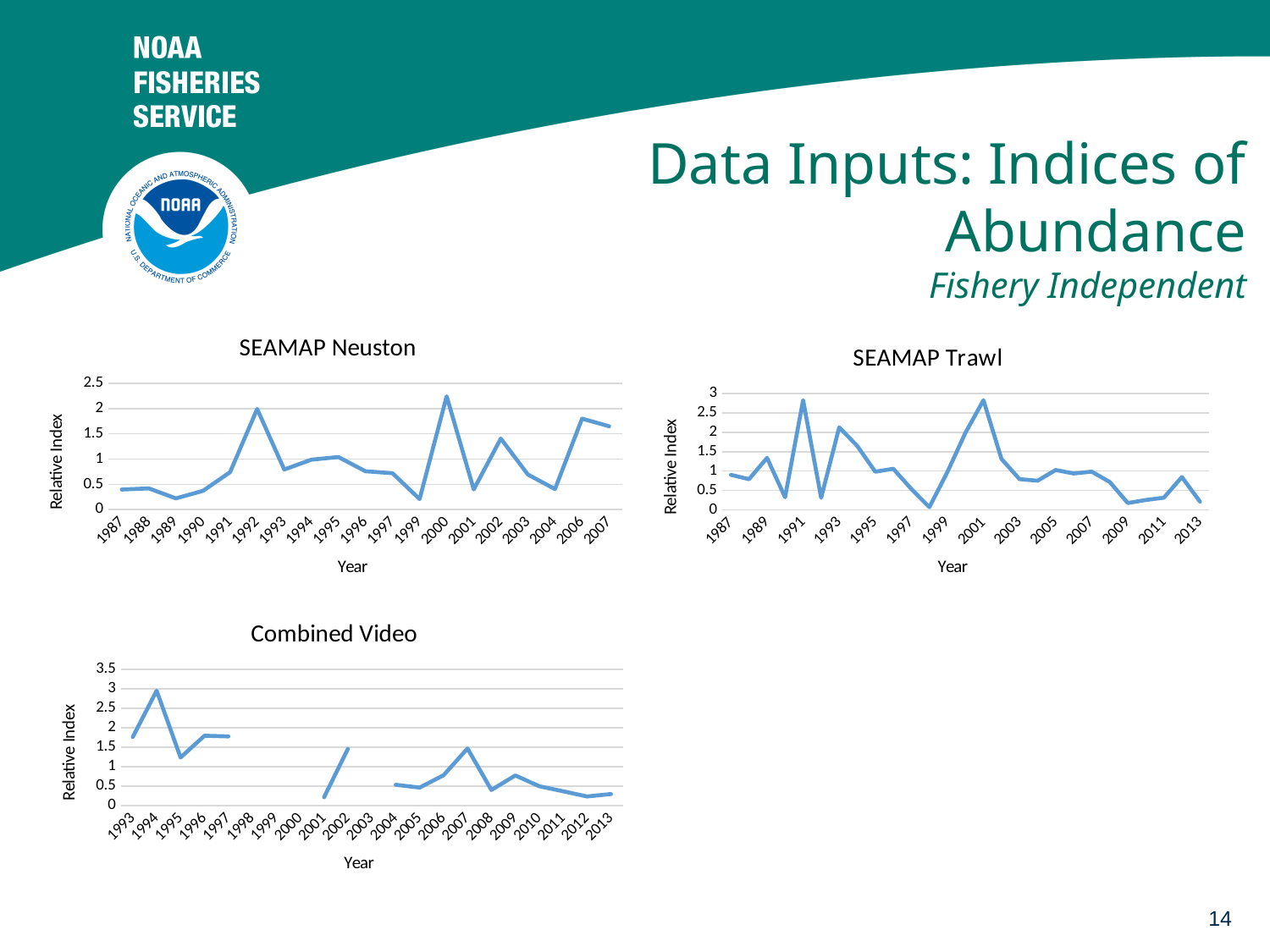
In the Combined Video chart, which year has the highest relative index? 1994 In the Combined Video chart, is the value for 2012 greater or less than 0.5? less How many charts are shown on the slide? 3 In the SEAMAP Trawl chart, is the value for 1993 greater or less than 1.5? greater In the SEAMAP Neuston chart, is the value for 1992 larger or smaller than the value for 1993? larger In the Combined Video chart, is the value for 1994 greater or less than 2.5? greater In the Combined Video chart, do the values rise or fall from 2007 to 2012? fall In the SEAMAP Neuston chart, which year has the highest relative index? 2000 What is the y-axis title of the SEAMAP Trawl chart? Relative Index What type of chart is the SEAMAP Neuston chart? line chart